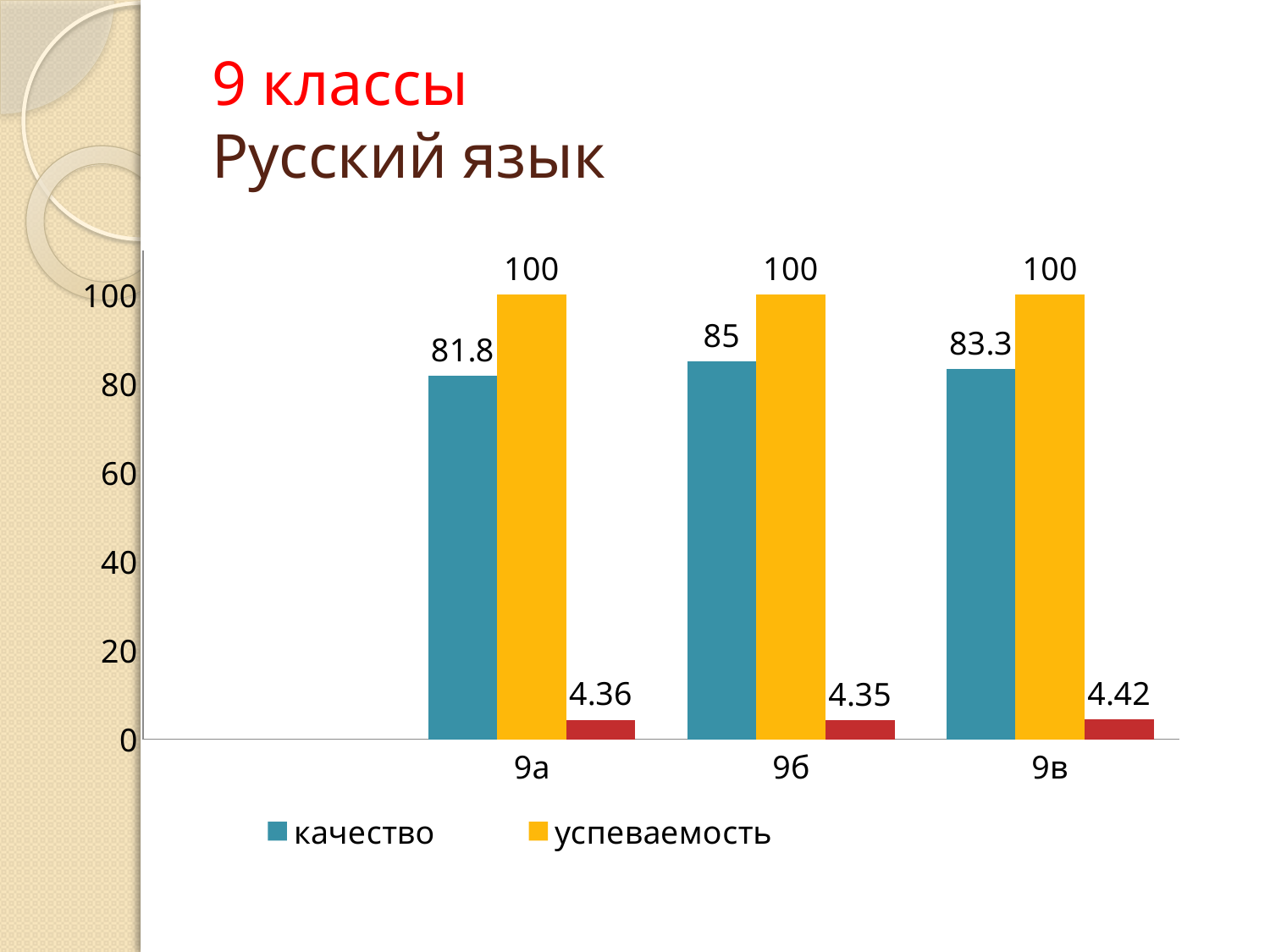
How many classes are shown on the x axis? 3 Which class has the lowest качество value? 9а What is the difference between the качество values for 9б and 9а? 3.2 What is the успеваемость value for class 9б? 100 Which is larger, the качество value for 9в or for 9а? 9в How many series does the legend list? 2 What is the value of the red bar for class 9в? 4.42 What is the качество value for class 9в? 83.3 Which class has the highest качество value? 9б What kind of chart is shown on the slide? bar chart What is the качество value for class 9а? 81.8 What is the качество value for class 9б? 85